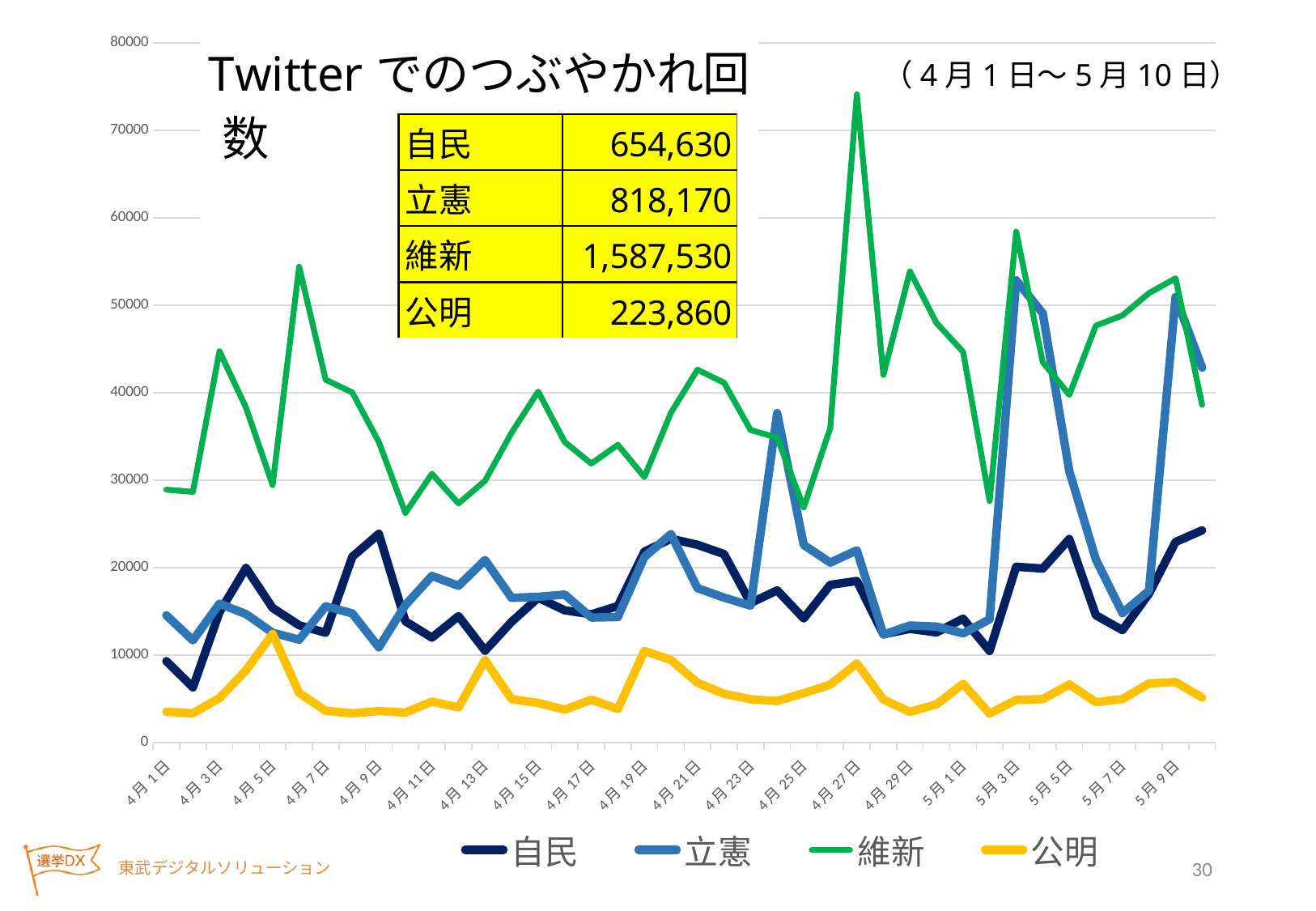
What kind of chart is shown on the slide? line chart According to the table on the slide, what is the total for 立憲? 818,170 According to the table on the slide, which party has the lowest total? 公明 What period does the chart cover, as stated on the slide? 4月1日～5月10日 Is the value for 自民 on 4月1日 greater or less than 10000? less On 4月27日, which series has the larger value, 維新 or 自民? 維新 Is the value for 維新 on 4月27日 greater or less than 70000? greater What colour is the 公明 line in the chart? yellow According to the table on the slide, what is the total for 維新? 1,587,530 According to the table on the slide, what is the total for 公明? 223,860 How many series does the legend list? 4 According to the table on the slide, which party has the highest total? 維新